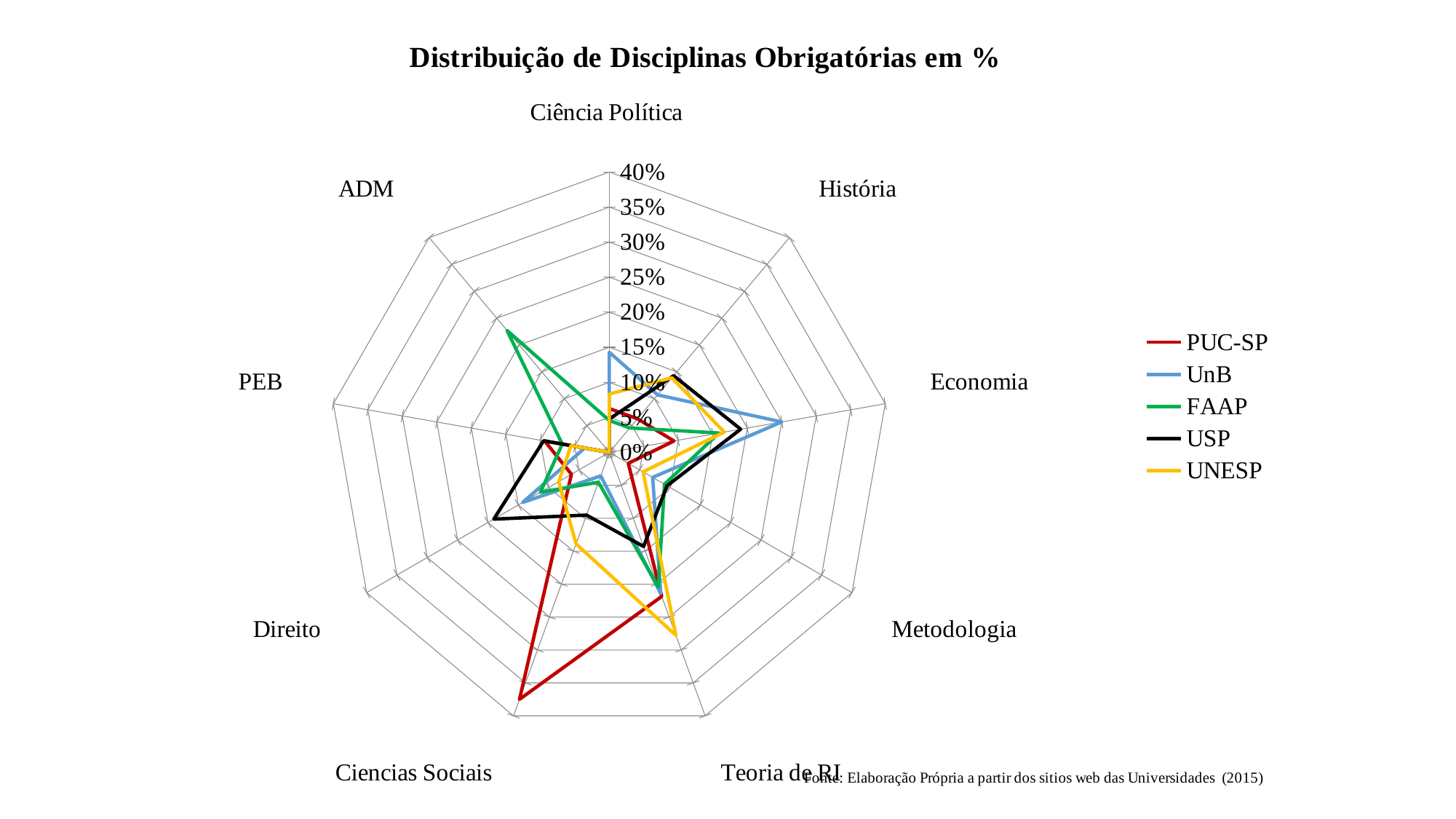
Is the value for FAAP in ADM greater or less than 15%? greater How many series does the legend list? 5 Is the value for PUC-SP in Ciencias Sociais greater or less than 30%? greater Which series has the highest value for Ciencias Sociais? PUC-SP What is the title of the chart? Distribuição de Disciplinas Obrigatórias em % How many categories (axes) does the radar chart have? 9 What kind of chart is shown on the slide? Radar chart Is the value for UnB in Ciência Política greater or less than 20%? less Which series has the highest value for ADM? FAAP Which series has the highest value for Economia? UnB Which colour represents FAAP in the chart? Green